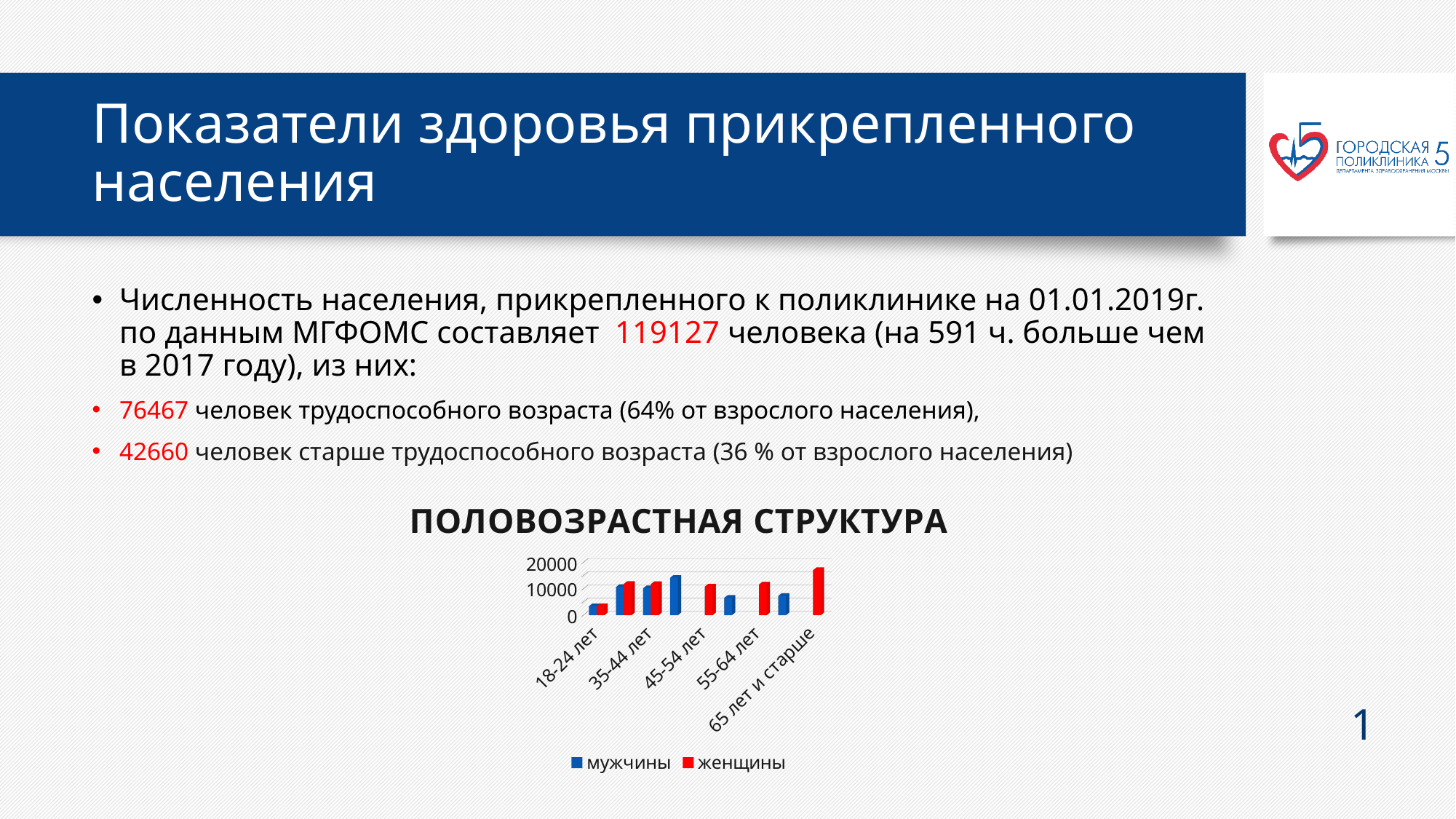
What is the highest value shown on the vertical axis of the ПОЛОВОЗРАСТНАЯ СТРУКТУРА chart? 20000 In the ПОЛОВОЗРАСТНАЯ СТРУКТУРА chart, is the value for женщины in the 65 лет и старше group greater or less than 10000? greater In the ПОЛОВОЗРАСТНАЯ СТРУКТУРА chart, which age group has the highest value for женщины? 65 лет и старше In the ПОЛОВОЗРАСТНАЯ СТРУКТУРА chart, which age group has the lowest value for женщины? 18-24 лет In the ПОЛОВОЗРАСТНАЯ СТРУКТУРА chart, which colour represents женщины? Red What are the two series named in the legend of the ПОЛОВОЗРАСТНАЯ СТРУКТУРА chart? мужчины and женщины In the ПОЛОВОЗРАСТНАЯ СТРУКТУРА chart, is the value for мужчины in the 18-24 лет group greater or less than 10000? less How many series does the legend of the ПОЛОВОЗРАСТНАЯ СТРУКТУРА chart list? 2 What kind of chart is shown under the title ПОЛОВОЗРАСТНАЯ СТРУКТУРА? Bar chart